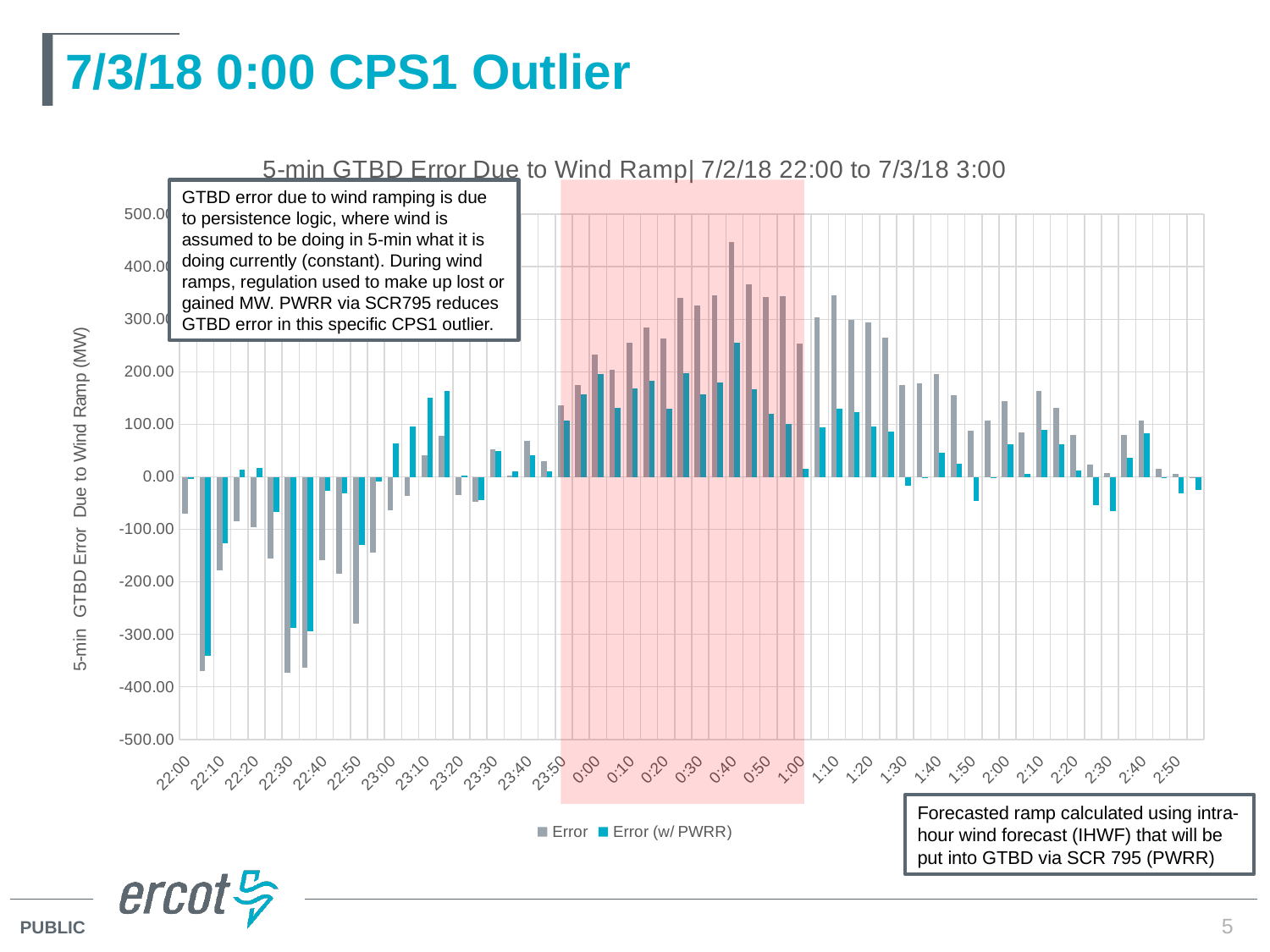
At which time label does the Error (w/ PWRR) series reach its highest value? 0:40 Is the Error (w/ PWRR) value at 0:40 greater or less than 200? greater At which time label does the Error series reach its highest value? 0:40 What are the two series named in the chart legend? Error and Error (w/ PWRR) At 0:30, which series has the larger value, Error or Error (w/ PWRR)? Error What is the title of the chart? 5-min GTBD Error Due to Wind Ramp| 7/2/18 22:00 to 7/3/18 3:00 Is the Error value at 22:10 greater or less than -300? greater What kind of chart is shown on the slide? Bar chart Is the Error value at 0:40 greater or less than 400? greater How many series does the chart legend list? 2 How many time labels are shown on the x axis? 30